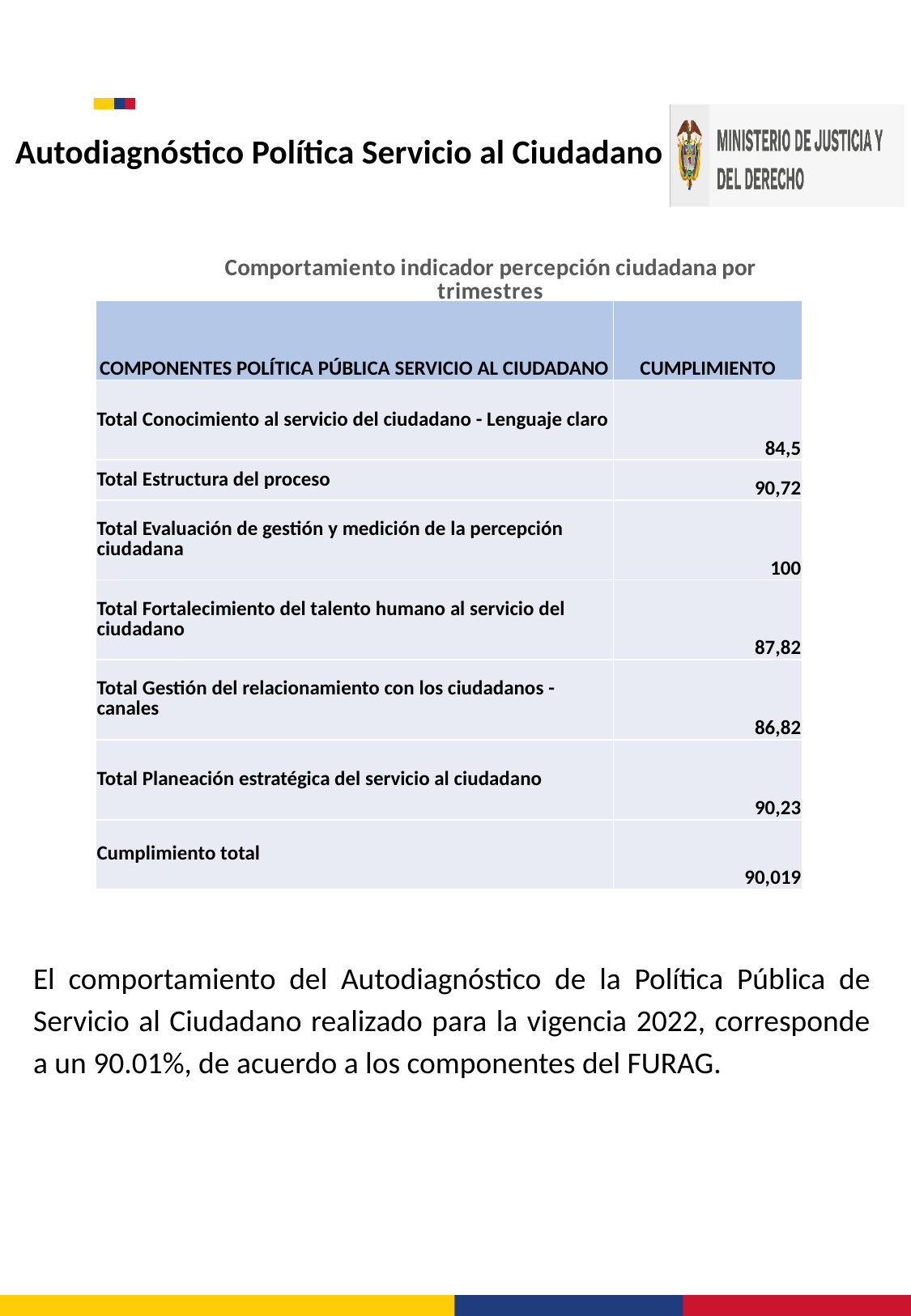
In the table, what is the CUMPLIMIENTO value for Total Conocimiento al servicio del ciudadano - Lenguaje claro? 84,5 Which component in the table has the highest CUMPLIMIENTO value? Total Evaluación de gestión y medición de la percepción ciudadana In the table, what is the value shown for Cumplimiento total? 90,019 Which has a higher CUMPLIMIENTO value: Total Estructura del proceso or Total Planeación estratégica del servicio al ciudadano? Total Estructura del proceso Which component in the table has the lowest CUMPLIMIENTO value? Total Conocimiento al servicio del ciudadano - Lenguaje claro In the table, what is the CUMPLIMIENTO value for Total Gestión del relacionamiento con los ciudadanos - canales? 86,82 What is the difference between the CUMPLIMIENTO values for Total Evaluación de gestión y medición de la percepción ciudadana and Total Conocimiento al servicio del ciudadano - Lenguaje claro? 15,5 In the table, what is the CUMPLIMIENTO value for Total Planeación estratégica del servicio al ciudadano? 90,23 How many component rows (excluding Cumplimiento total) are listed in the table? 6 In the table, what is the CUMPLIMIENTO value for Total Estructura del proceso? 90,72 What is the title shown above the table? Comportamiento indicador percepción ciudadana por trimestres In the table, what is the CUMPLIMIENTO value for Total Fortalecimiento del talento humano al servicio del ciudadano? 87,82